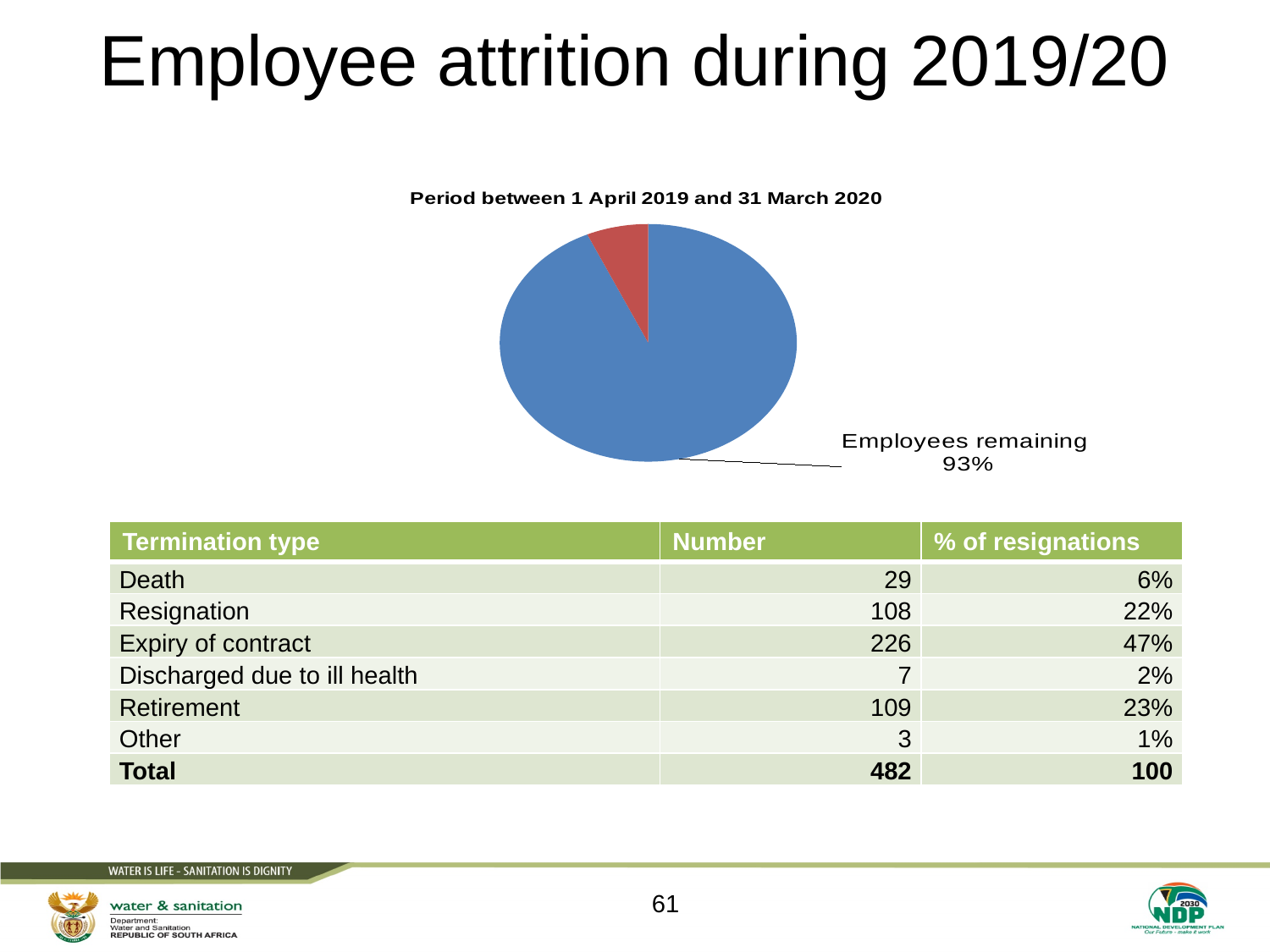
What share of the pie does the Employees remaining slice represent? 93% What colour is the Employees remaining slice in the pie chart? blue Which slice of the pie chart is the largest? Employees remaining What kind of chart is shown on the slide? pie chart How many slices does the pie chart have? 2 What is the title of the pie chart? Period between 1 April 2019 and 31 March 2020 Is the share for Employees remaining greater or less than 50%? greater